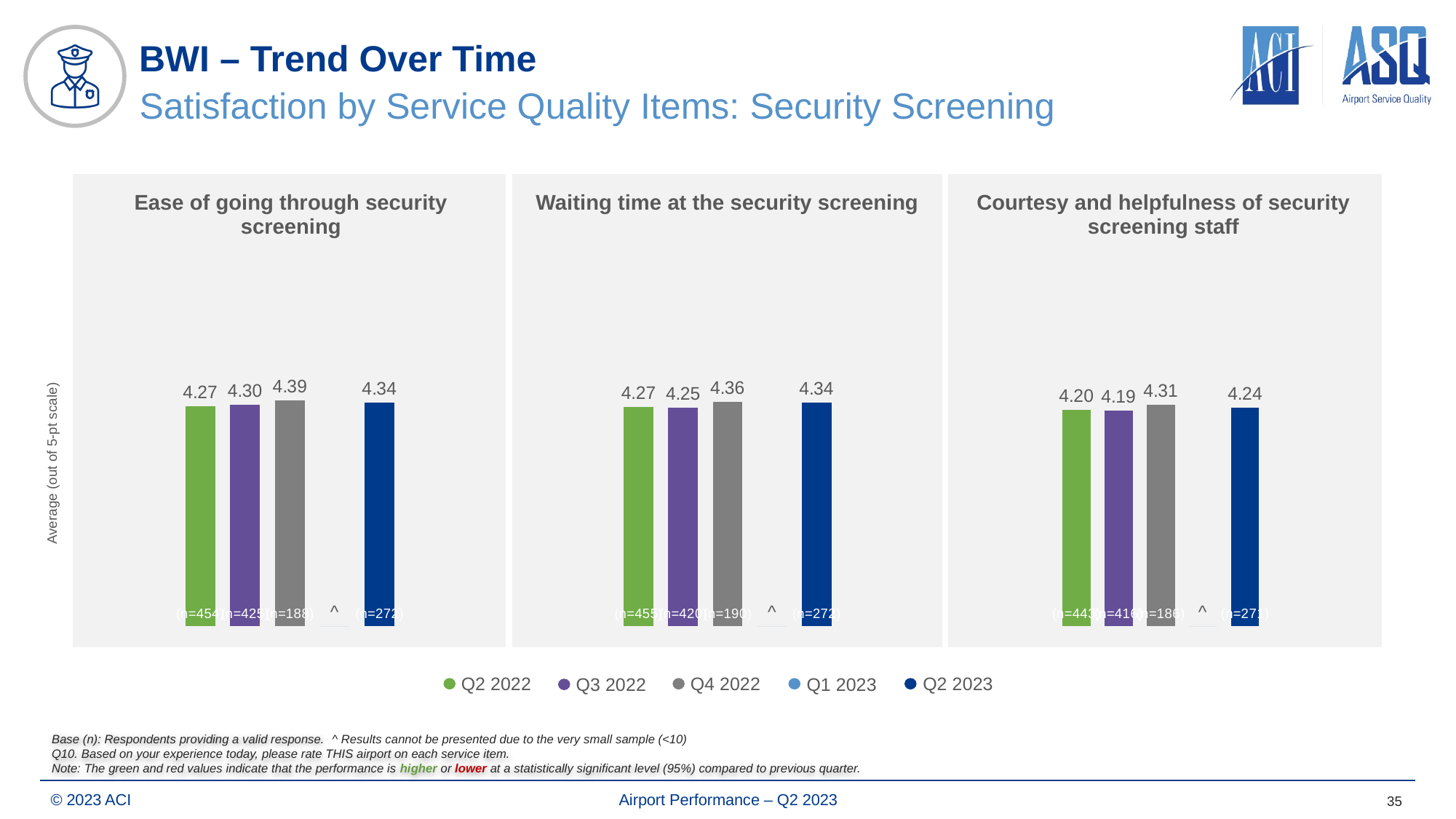
In the 'Ease of going through security screening' chart, what is the difference between the Q4 2022 and Q2 2023 values? 0.05 How many series does the legend list? 5 In the 'Waiting time at the security screening' chart, what is the value for Q2 2023? 4.34 In the 'Courtesy and helpfulness of security screening staff' chart, which quarter has the highest value? Q4 2022 In the 'Ease of going through security screening' chart, what is the value for Q4 2022? 4.39 What kind of chart is used on this slide? Bar chart In the 'Courtesy and helpfulness of security screening staff' chart, what is the difference between the Q2 2023 and Q2 2022 values? 0.04 In the 'Waiting time at the security screening' chart, which is larger: the Q2 2022 value or the Q2 2023 value? Q2 2023 Which quarter in the legend has no bar shown in any of the three charts? Q1 2023 In the 'Ease of going through security screening' chart, how many bars are plotted? 4 In the 'Waiting time at the security screening' chart, which quarter has the lowest value? Q3 2022 In the 'Courtesy and helpfulness of security screening staff' chart, what is the value for Q3 2022? 4.19